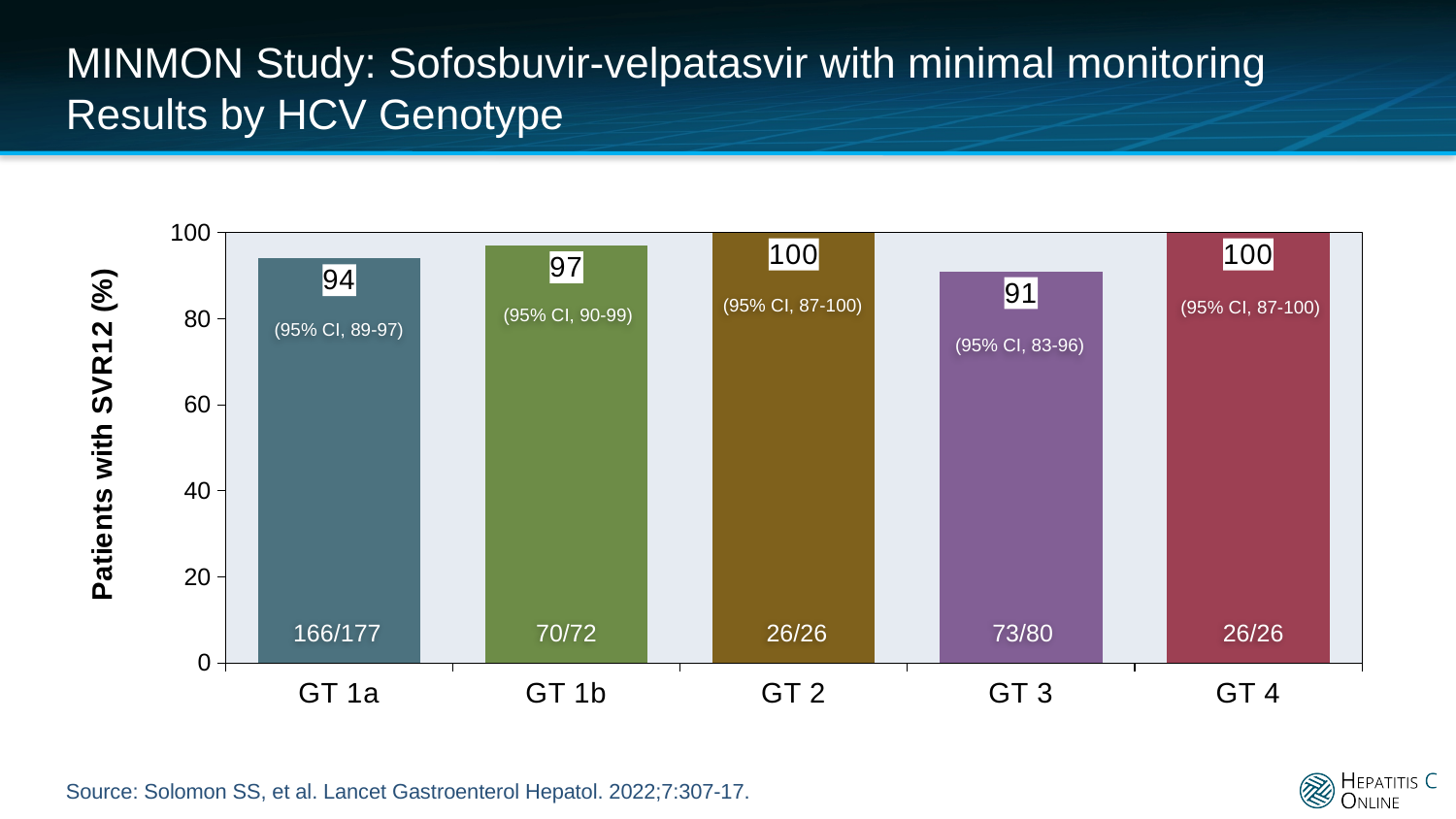
Is the value for GT 3 greater or less than 80? greater What is the SVR12 rate for GT 3? 91 Which has a higher SVR12 rate, GT 1a or GT 1b? GT 1b What is the difference in SVR12 rate between GT 1b and GT 3? 6 What is the 95% confidence interval shown for GT 3? (95% CI, 83-96) What is the SVR12 rate for GT 1b? 97 What is the label on the y axis? Patients with SVR12 (%) How many patients achieved SVR12 out of the total for GT 1a? 166/177 Which genotype has the lowest SVR12 rate? GT 3 How many genotype categories are shown on the x axis? 5 What kind of chart is shown on the slide? Bar chart What is the SVR12 rate for GT 1a? 94